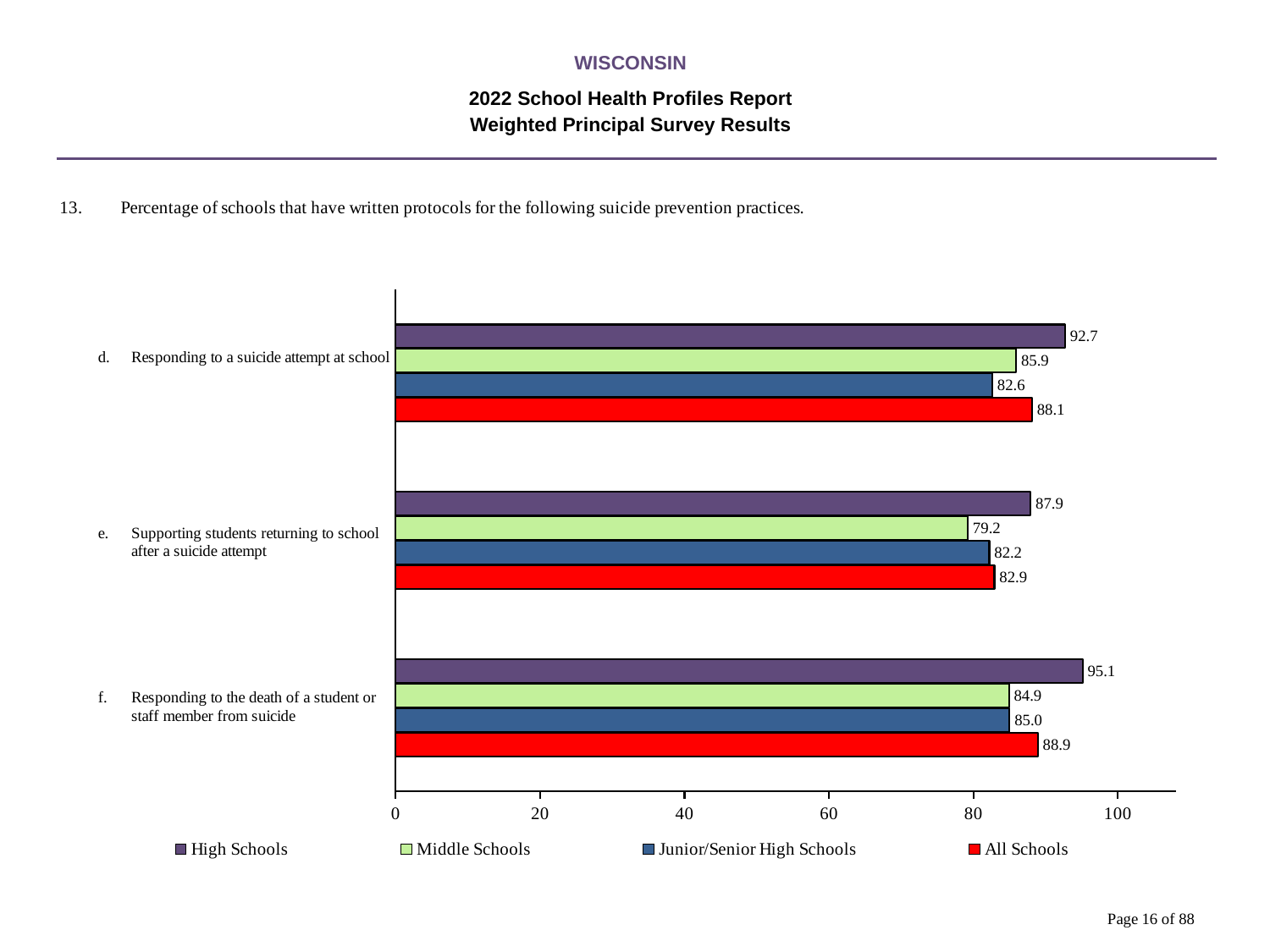
Which category has the lowest value for Middle Schools? Supporting students returning to school after a suicide attempt What is the value for High Schools for 'Responding to a suicide attempt at school'? 92.7 What is the difference between the High Schools and Middle Schools values for 'Responding to a suicide attempt at school'? 6.8 What is the value for Junior/Senior High Schools for 'Responding to a suicide attempt at school'? 82.6 How many series does the legend list? 4 For 'Supporting students returning to school after a suicide attempt', which is larger: the High Schools value or the All Schools value? High Schools Is the Middle Schools value for 'Supporting students returning to school after a suicide attempt' greater or less than 80? less What is the value for Middle Schools for 'Supporting students returning to school after a suicide attempt'? 79.2 What kind of chart is shown on the slide? bar chart How many categories are shown on the chart? 3 Which category has the highest value for High Schools? Responding to the death of a student or staff member from suicide What is the value for All Schools for 'Responding to the death of a student or staff member from suicide'? 88.9